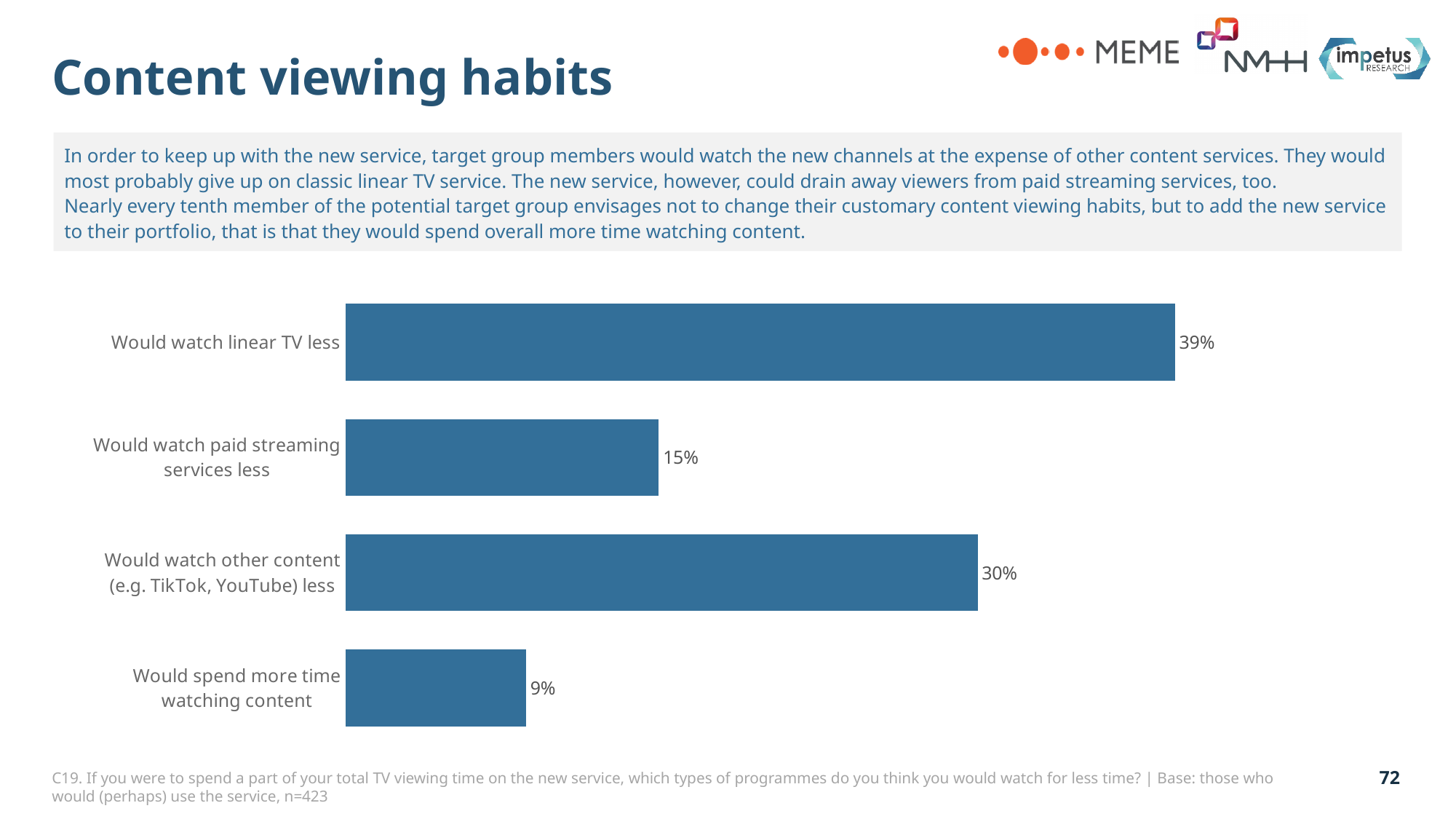
Which is larger: the value for 'Would watch paid streaming services less' or 'Would watch other content (e.g. TikTok, YouTube) less'? Would watch other content (e.g. TikTok, YouTube) less Which category has the highest value? Would watch linear TV less What percentage would watch paid streaming services less? 15% What percentage would watch other content (e.g. TikTok, YouTube) less? 30% Which category has the lowest value? Would spend more time watching content What is the difference between the value for 'Would watch linear TV less' and 'Would watch other content (e.g. TikTok, YouTube) less'? 9% What percentage would watch linear TV less? 39% What kind of chart is shown on the slide? Bar chart What is the title of the slide containing the chart? Content viewing habits How many categories are shown in the chart? 4 What is the difference between the value for 'Would watch paid streaming services less' and 'Would spend more time watching content'? 6% What percentage would spend more time watching content? 9%